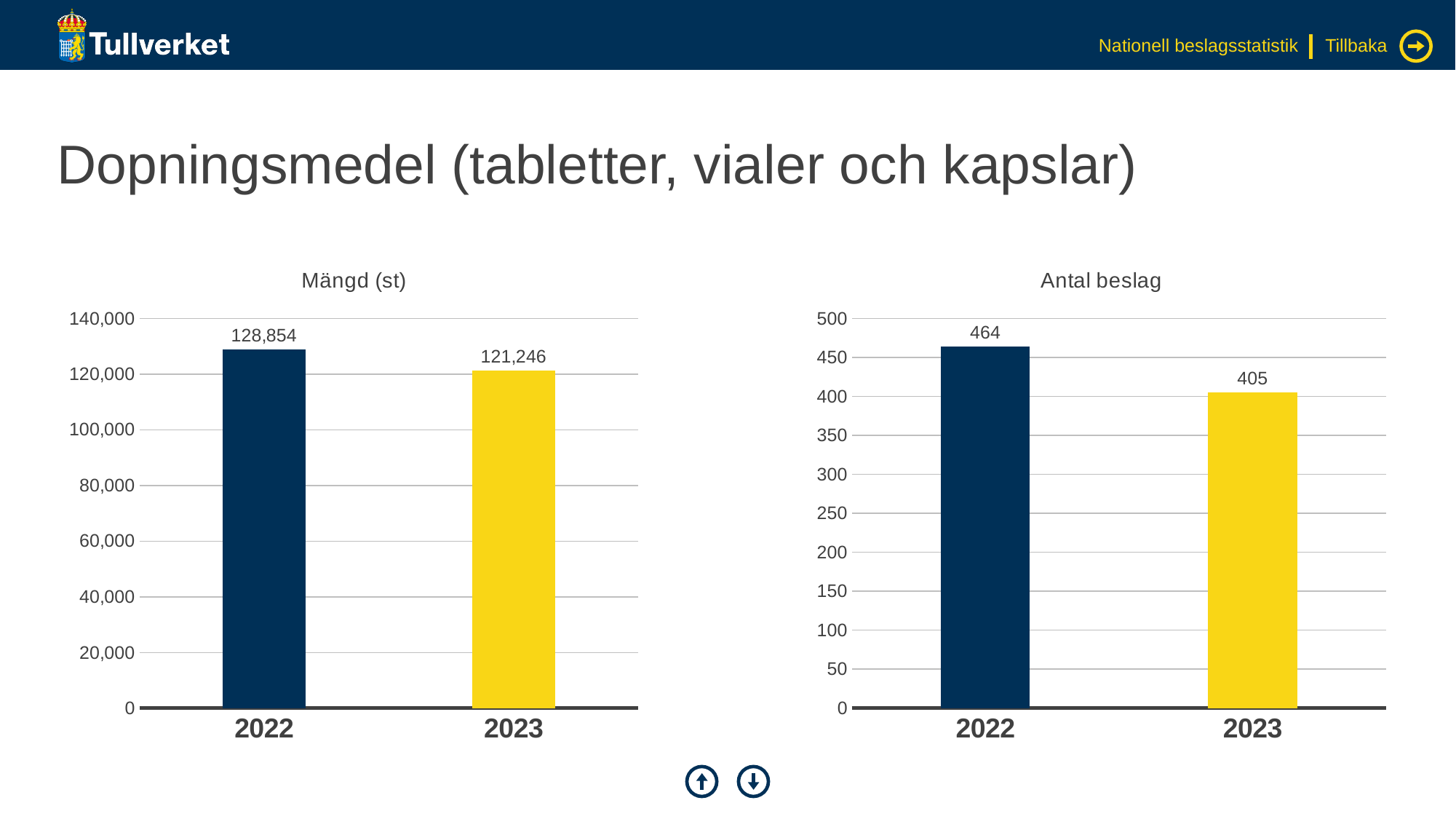
What kind of chart is the 'Antal beslag' chart? bar chart In the 'Mängd (st)' chart, what is the difference between the 2022 and 2023 values? 7,608 In the 'Antal beslag' chart, which year has the lowest value? 2023 In the 'Mängd (st)' chart, what is the value for 2023? 121,246 In the 'Mängd (st)' chart, what is the value for 2022? 128,854 In the 'Mängd (st)' chart, do the values rise or fall from 2022 to 2023? fall In the 'Antal beslag' chart, is the value for 2023 greater or less than 450? less How many years are shown in the 'Mängd (st)' chart? 2 In the 'Mängd (st)' chart, which year has the highest value? 2022 In the 'Antal beslag' chart, what is the value for 2022? 464 In the 'Antal beslag' chart, what is the value for 2023? 405 In the 'Antal beslag' chart, what is the difference between the 2022 and 2023 values? 59